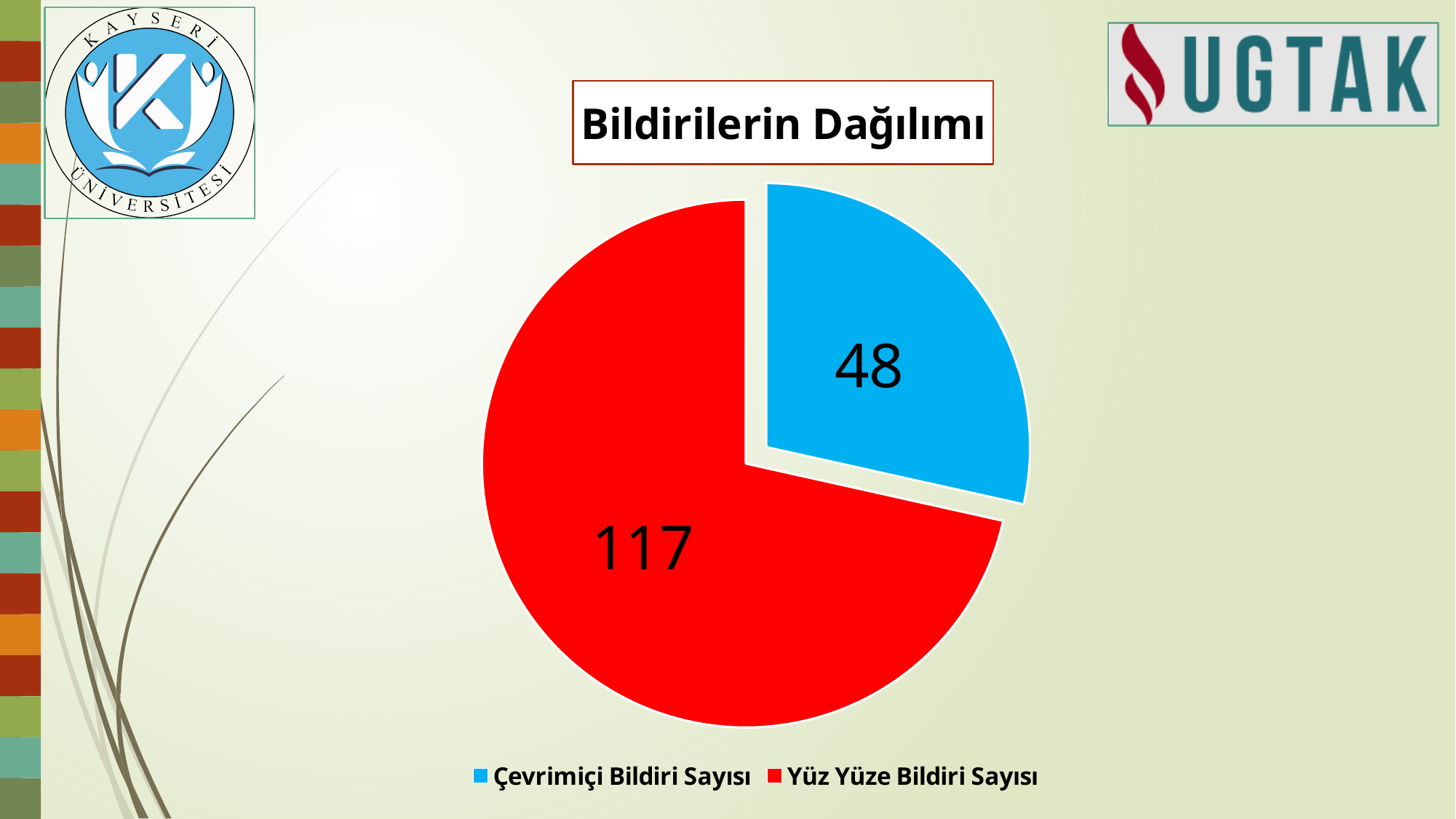
What kind of chart is shown on the slide? Pie chart What is the difference between Yüz Yüze Bildiri Sayısı and Çevrimiçi Bildiri Sayısı? 69 What is the value for Yüz Yüze Bildiri Sayısı? 117 Which category has the largest slice of the pie? Yüz Yüze Bildiri Sayısı What is the title of the chart? Bildirilerin Dağılımı What share of the pie does Yüz Yüze Bildiri Sayısı represent, to the nearest whole percent? 71% What is the value for Çevrimiçi Bildiri Sayısı? 48 What is the total of all slices in the pie chart? 165 Which category has the smallest slice of the pie? Çevrimiçi Bildiri Sayısı Which is larger, Çevrimiçi Bildiri Sayısı or Yüz Yüze Bildiri Sayısı? Yüz Yüze Bildiri Sayısı How many categories does the pie chart show? 2 What colour is the slice for Çevrimiçi Bildiri Sayısı? Blue